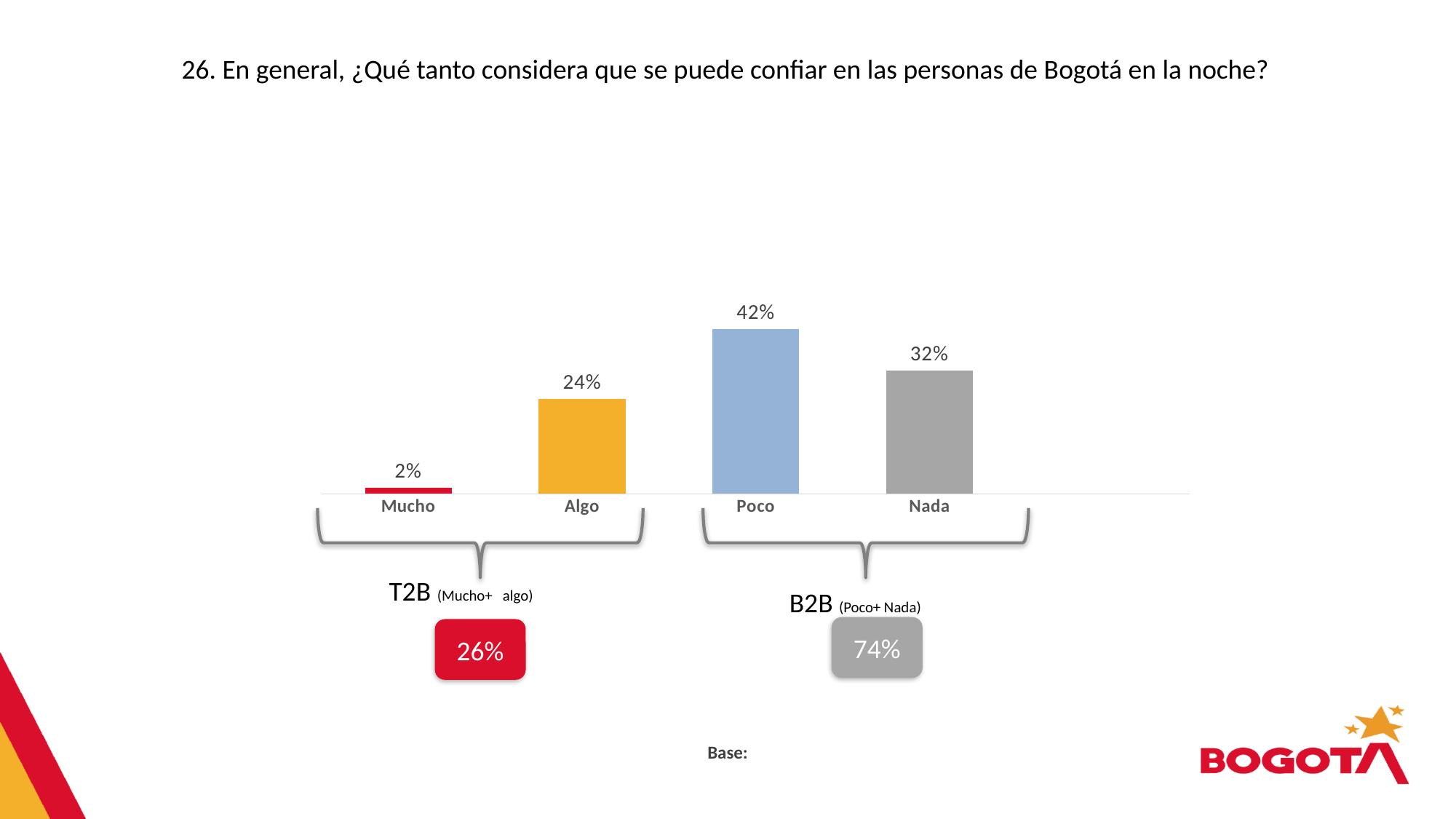
What is the value for Poco? 42% Which is larger, the value for Algo or the value for Nada? Nada What is the T2B (Mucho + Algo) value shown on the slide? 26% What is the difference between the values for Poco and Nada? 10% What is the value for Algo? 24% What is the value for Nada? 32% What is the value for Mucho? 2% What is the B2B (Poco + Nada) value shown on the slide? 74% How many categories are shown in the chart? 4 Which category has the highest value? Poco What kind of chart is shown on the slide? Bar chart Which category has the lowest value? Mucho